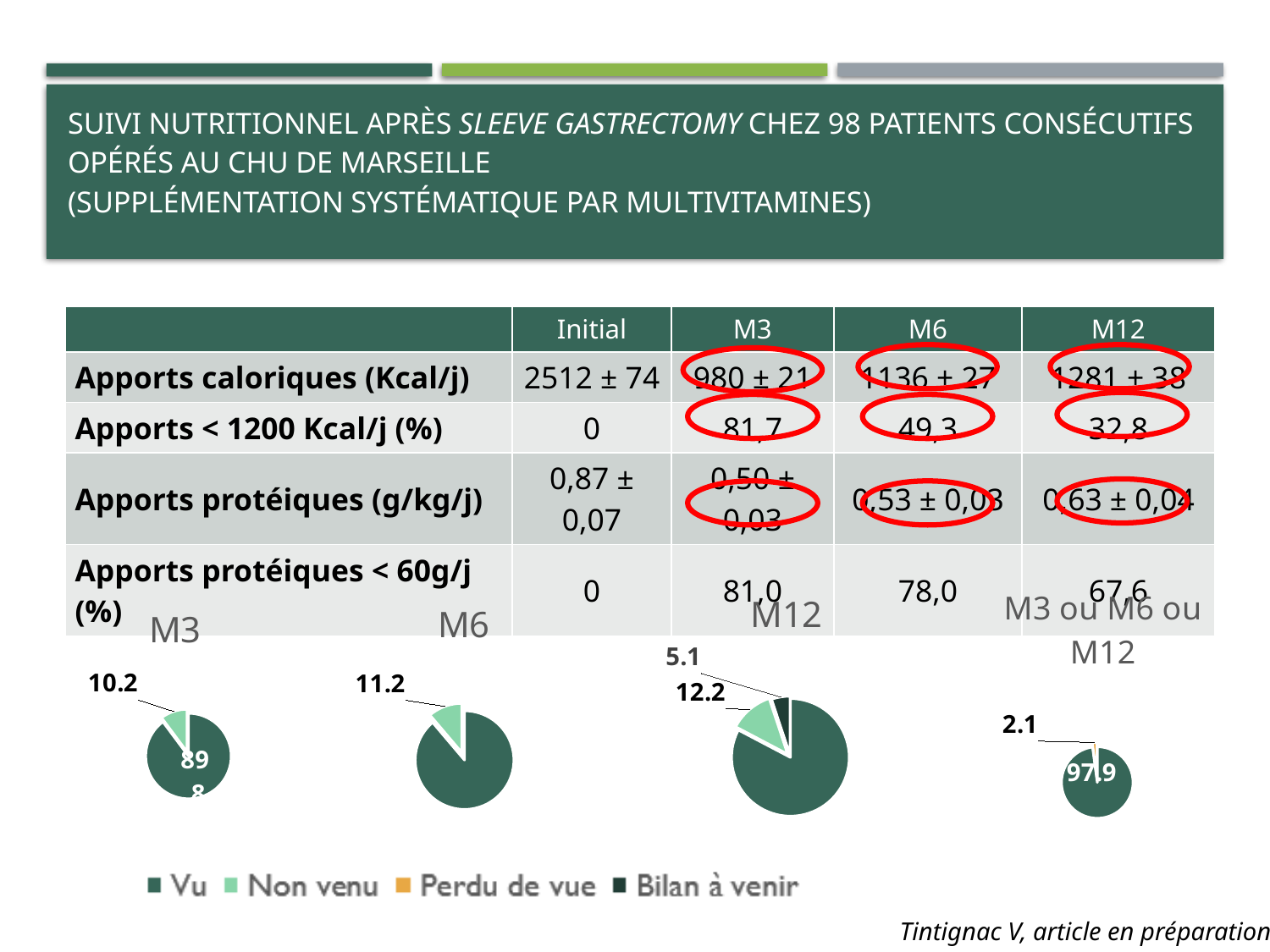
In the M12 pie chart, what is the value of the Bilan à venir slice? 5.1 In the M3 pie chart, what is the value of the Non venu slice? 10.2 In the 'M3 ou M6 ou M12' pie chart, what is the value of the small slice? 2.1 What kind of charts are shown at the bottom of the slide? Pie charts In the M6 pie chart, what is the value of the Non venu slice? 11.2 In the M12 pie chart, what is the value of the Non venu slice? 12.2 Which of the four pie charts has the largest Vu share? M3 ou M6 ou M12 In the 'M3 ou M6 ou M12' pie chart, what is the value of the Vu slice? 97.9 How many pie charts are shown on the slide? 4 What is the difference between the Non venu value in the M12 pie chart and the Non venu value in the M3 pie chart? 2.0 Is the Non venu slice larger in the M3 pie chart or in the M6 pie chart? M6 How many entries does the legend below the pie charts list? 4